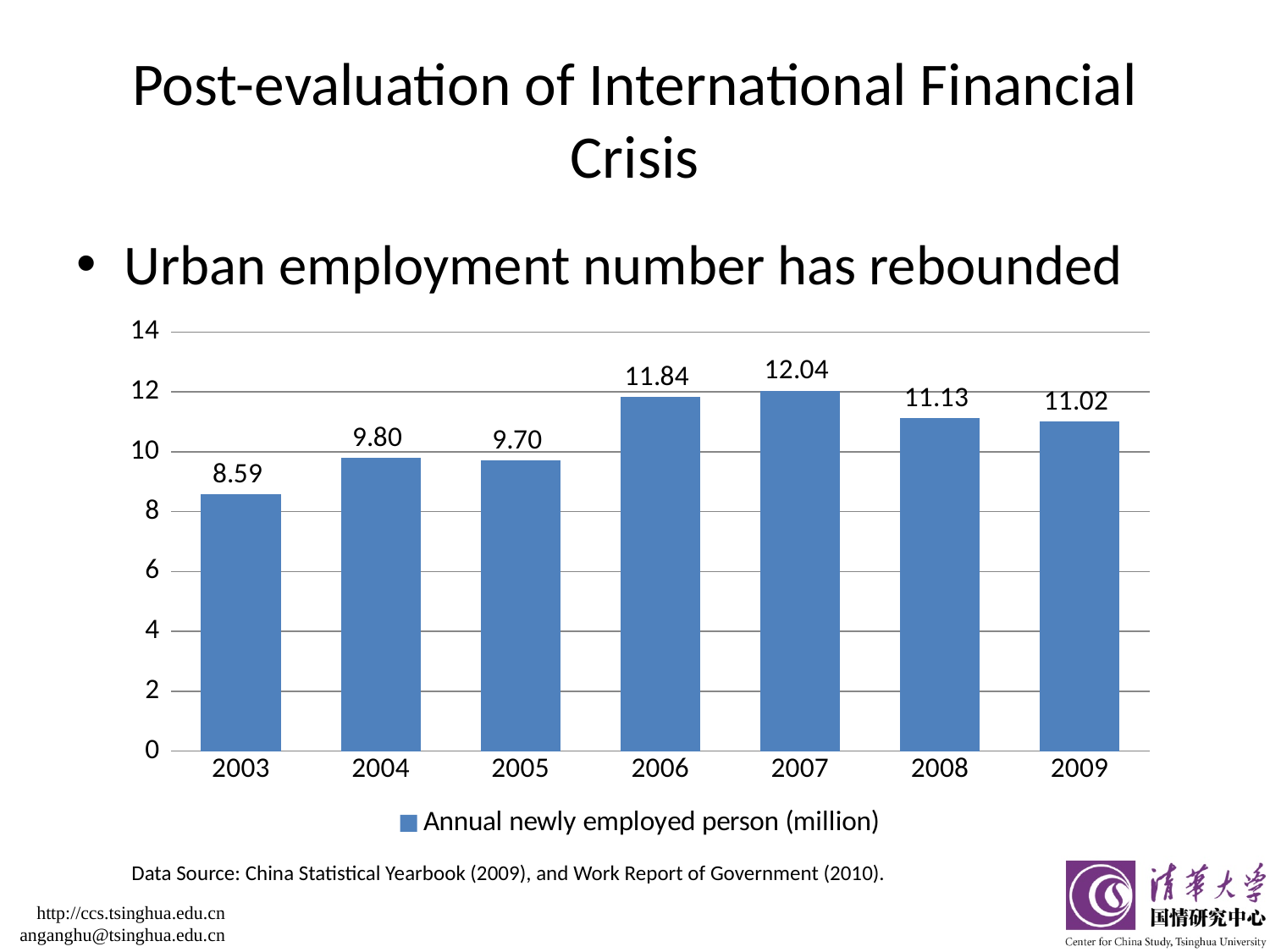
Which year has the highest value? 2007 How many years are shown on the x axis? 7 What is the value for 2003? 8.59 Which is larger, the value for 2004 or the value for 2005? 2004 Is the value for 2008 greater or less than 10? greater What is the value for 2009? 11.02 What is the difference between the values for 2006 and 2005? 2.14 What kind of chart is this? bar chart What is the value for 2007? 12.04 What is the difference between the values for 2007 and 2003? 3.45 Which year has the lowest value? 2003 What series does the legend list? Annual newly employed person (million)